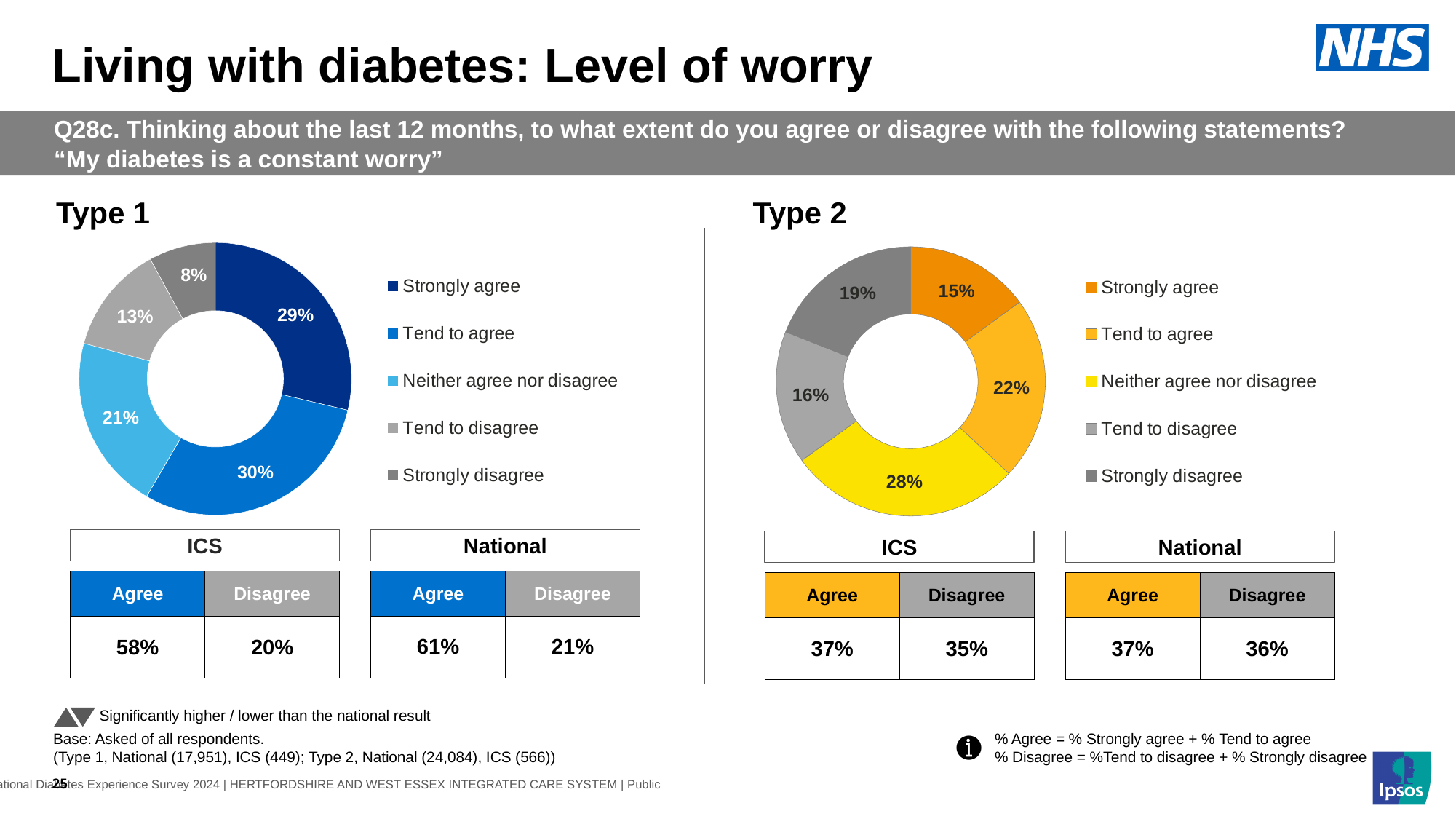
What kind of chart is used for Type 1? Doughnut (pie) chart How many response categories does the legend of the Type 2 chart list? 5 In the Type 1 chart, which response category has the largest share? Tend to agree In the Type 2 chart, which response category has the smallest share? Strongly agree In the Type 2 chart, what is the difference between the 'Neither agree nor disagree' share and the 'Strongly agree' share? 13 percentage points In the Type 2 chart, what percentage of respondents said they neither agree nor disagree? 28% In the Type 2 chart, what colour represents 'Strongly agree'? Orange In the Type 1 chart, which is larger: the 'Tend to disagree' share or the 'Strongly disagree' share? Tend to disagree In the Type 1 chart, what percentage of respondents said they strongly agree? 29% In the Type 2 chart, what share of the pie is 'Strongly disagree'? 19% In the Type 1 chart, which response category has the smallest share? Strongly disagree In the Type 1 chart, what colour represents 'Neither agree nor disagree'? Light blue